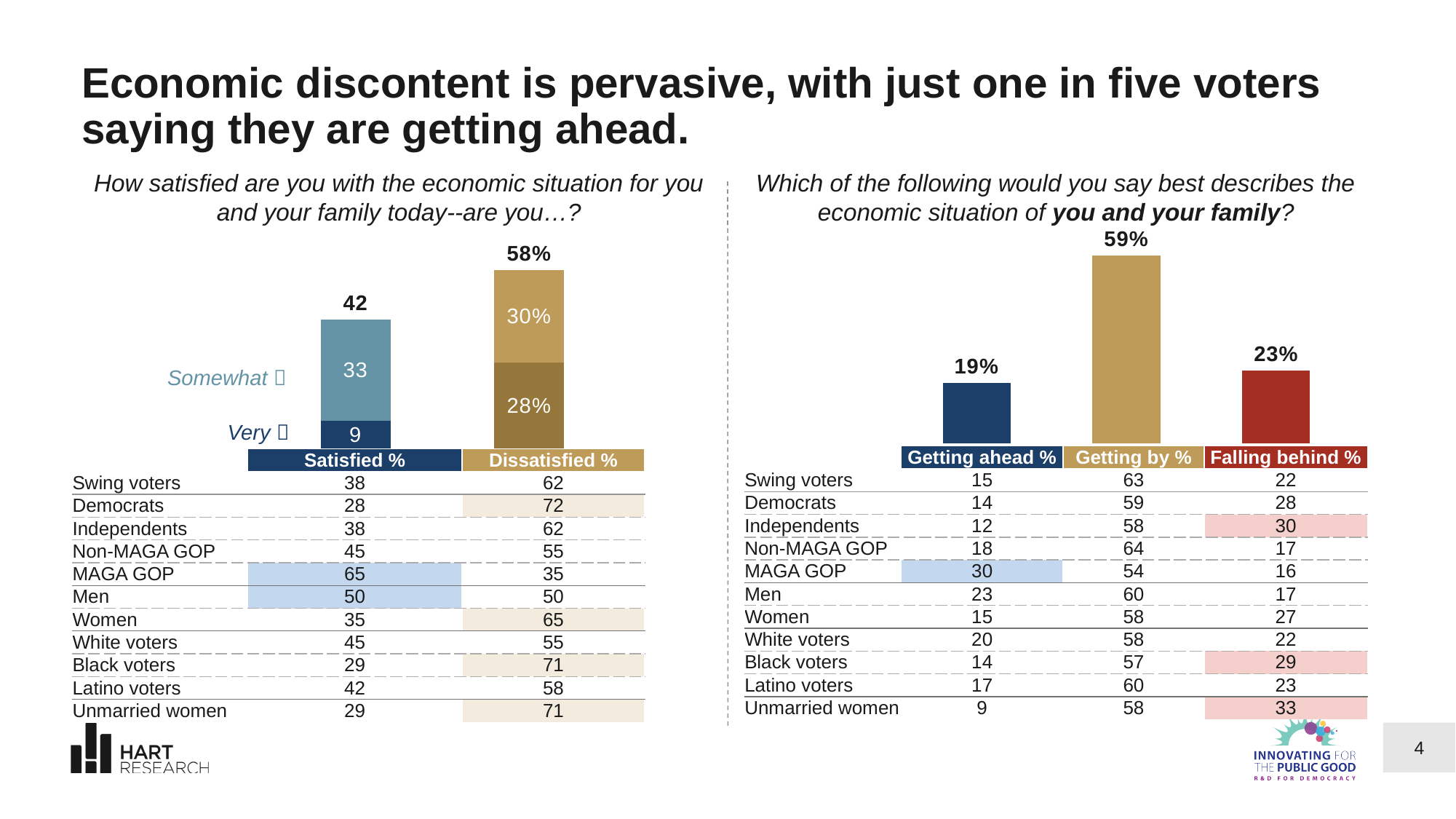
How many bars are in the right chart on the economic situation of you and your family? 3 In the right chart on the economic situation of you and your family, which category has the lowest value? Getting ahead In the left chart on economic satisfaction, what is the 'Very' satisfied value? 9 In the left chart on economic satisfaction, what is the total for the Satisfied bar? 42 In the left chart on economic satisfaction, what is the total for the Dissatisfied bar? 58% In the right chart on the economic situation of you and your family, what percentage say they are getting by? 59% In the left chart on economic satisfaction, what is the larger segment of the Dissatisfied bar? 30% In the right chart on the economic situation of you and your family, what is the difference between Falling behind and Getting ahead? 4% In the left chart on economic satisfaction, what is the difference between the Dissatisfied total and the Satisfied total? 16 In the right chart on the economic situation of you and your family, what percentage say they are getting ahead? 19% In the left chart on economic satisfaction, what is the 'Somewhat' satisfied value? 33 In the left chart on economic satisfaction, which bar is taller, Satisfied or Dissatisfied? Dissatisfied